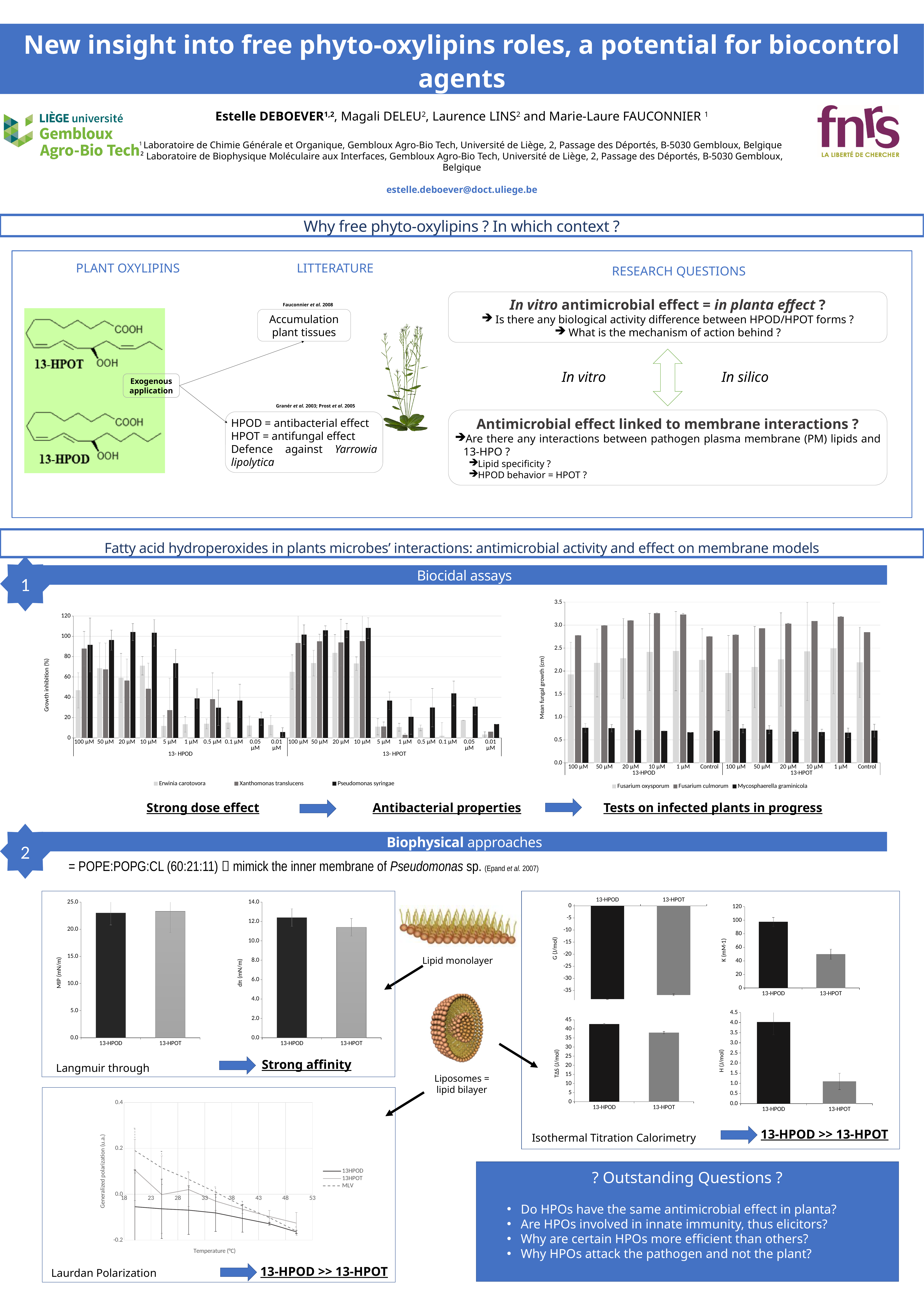
In the Growth inhibition (%) chart, is the value for Pseudomonas syringae at 100 µM 13-HPOD greater or less than 80? greater In the Laurdan Polarization chart, how many series does the legend list? 3 In the Mean fungal growth (cm) chart, which series has the lowest bars across all conditions? Mycosphaerella graminicola In the TΔS (J/mol) chart, which is larger, 13-HPOD or 13-HPOT? 13-HPOD In the Growth inhibition (%) chart, what kind of chart is used? bar chart In the ΔH (J/mol) chart, is the value for 13-HPOD greater or less than 3.0? greater In the Growth inhibition (%) chart, is the value for Erwinia carotovora at 0.01 µM 13-HPOD greater or less than 20? less In the Growth inhibition (%) chart, how many series does the legend list? 3 In the Laurdan Polarization chart, do the generalized polarization values rise or fall as temperature increases? fall In the K (mM-1) chart, which is larger, 13-HPOD or 13-HPOT? 13-HPOD